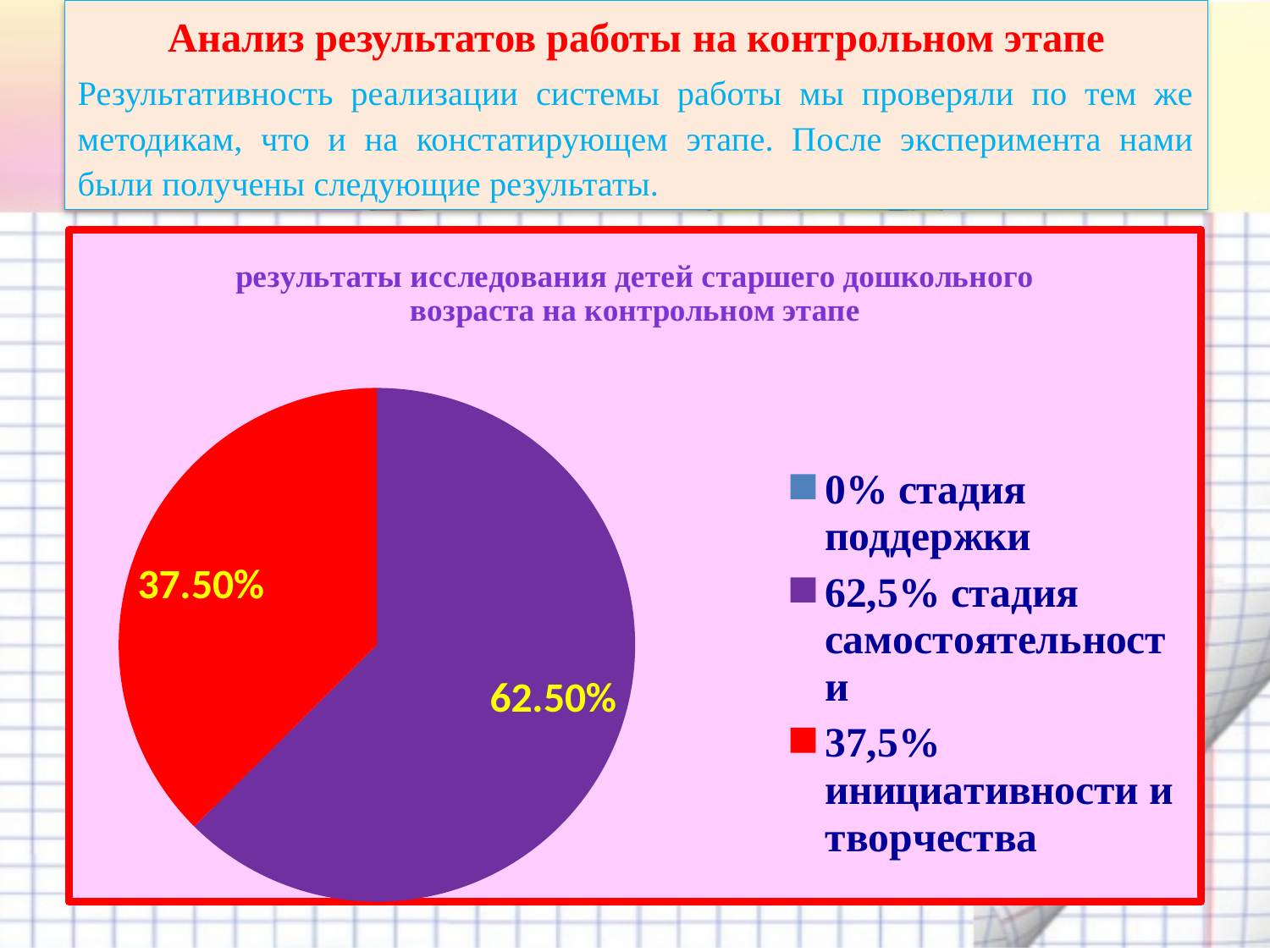
What share of the pie does the 'инициативности и творчества' slice take? 37.50% What value is printed on the purple slice of the pie? 62.50% What is the difference between the purple slice's value and the red slice's value? 25.00% What is the title of the chart? результаты исследования детей старшего дошкольного возраста на контрольном этапе Which legend entry corresponds to the largest slice of the pie? 62,5% стадия самостоятельности What value is printed on the red slice of the pie? 37.50% Is the value of the red slice greater or less than 50%? less Which slice is larger, the red one or the purple one? the purple one What colour is the slice labelled 62.50%? purple How many entries does the chart's legend list? 3 What kind of chart is shown on the slide? pie chart Which legend entry has the smallest share according to the legend? 0% стадия поддержки